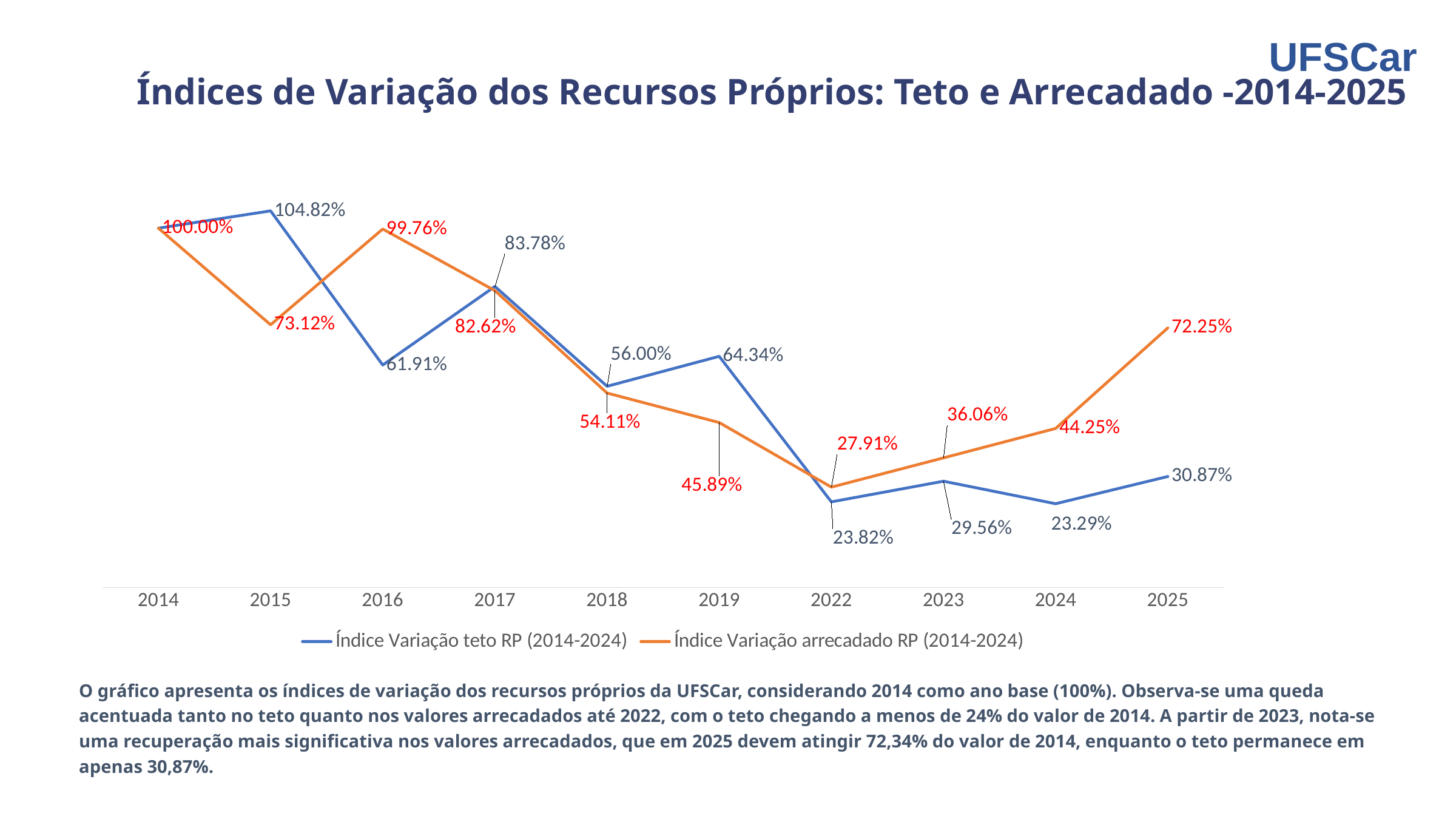
What is the value of Índice Variação arrecadado RP in 2025? 72.25% What is the value of Índice Variação teto RP in 2015? 104.82% In 2019, which series has the higher value: Índice Variação teto RP or Índice Variação arrecadado RP? Índice Variação teto RP Does Índice Variação arrecadado RP rise or fall from 2022 to 2025? Rise What kind of chart is shown on the slide? Line chart How many years are shown on the x axis of the chart? 10 What is the value of Índice Variação teto RP in 2022? 23.82% What is the difference between Índice Variação arrecadado RP and Índice Variação teto RP in 2025? 41.38% In which year does Índice Variação teto RP reach its highest value? 2015 In which year does Índice Variação arrecadado RP reach its lowest value? 2022 How many series does the legend list? 2 What is the value of Índice Variação arrecadado RP in 2019? 45.89%